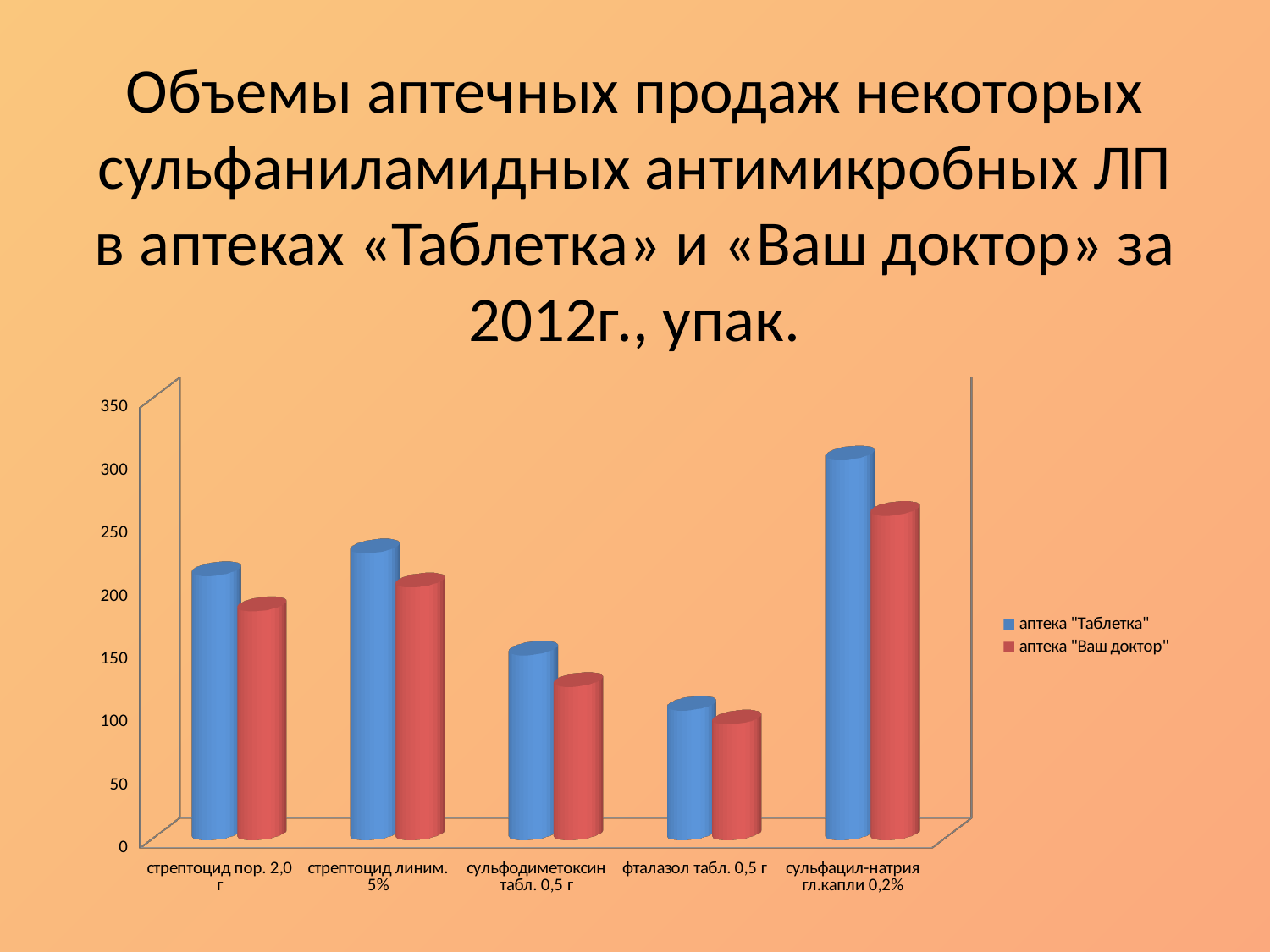
How many series does the chart legend list? 2 Which category has the highest value for аптека "Таблетка"? сульфацил-натрия гл.капли 0,2% How many drug categories are shown on the x axis of the chart? 5 For аптека "Таблетка", which is larger: стрептоцид линим. 5% or сульфодиметоксин табл. 0,5 г? стрептоцид линим. 5% Which category has the lowest value for аптека "Ваш доктор"? фталазол табл. 0,5 г What colour are the bars for аптека "Таблетка" in the chart? blue Which category has the lowest value for аптека "Таблетка"? фталазол табл. 0,5 г For стрептоцид пор. 2,0 г, which pharmacy has the larger value: аптека "Таблетка" or аптека "Ваш доктор"? аптека "Таблетка" Is the value for фталазол табл. 0,5 г at аптека "Ваш доктор" greater or less than 150? less Is the value for сульфацил-натрия гл.капли 0,2% at аптека "Таблетка" greater or less than 250? greater What kind of chart is shown on the slide? bar chart Which category has the highest value for аптека "Ваш доктор"? сульфацил-натрия гл.капли 0,2%